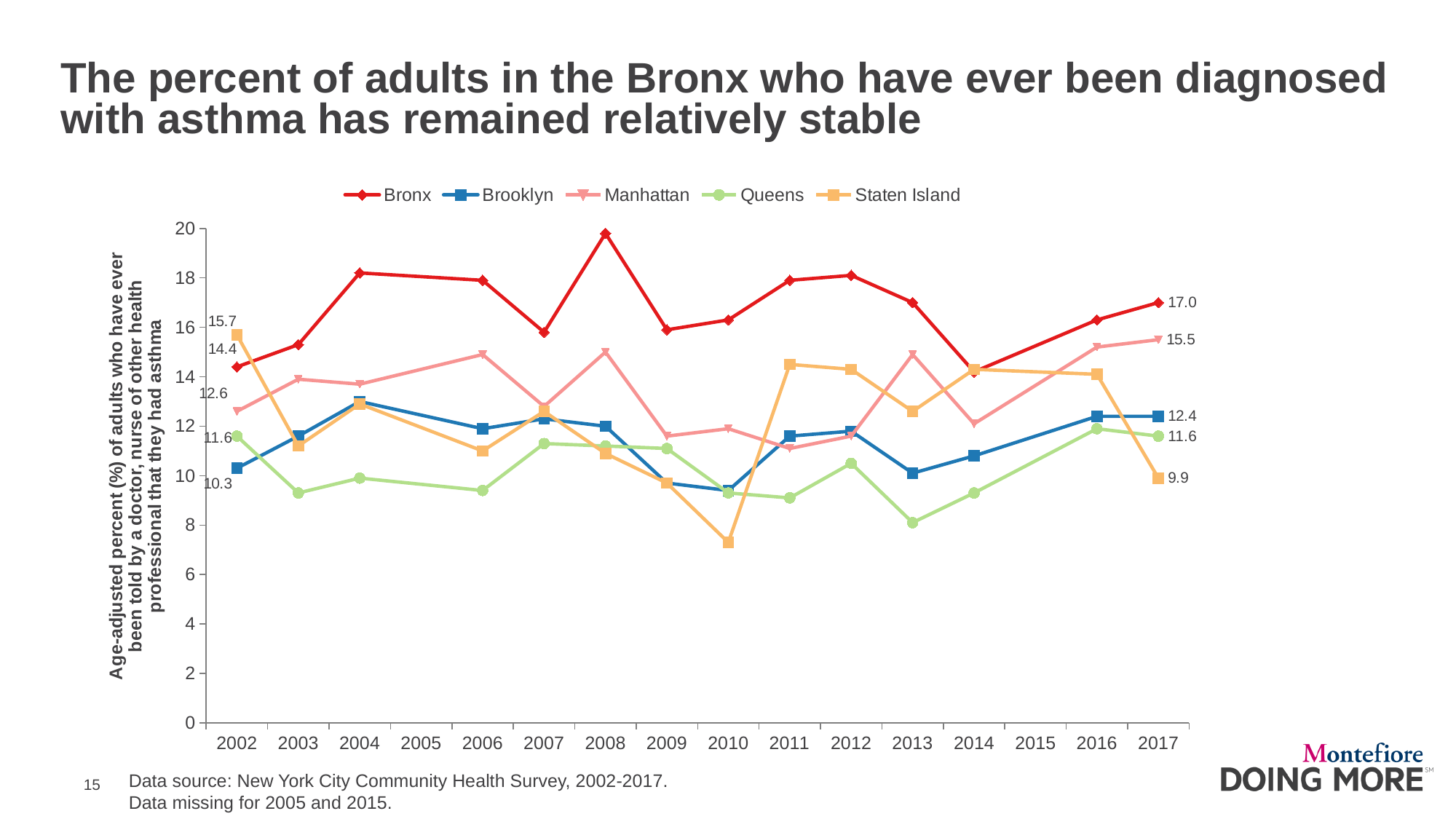
Is the value for the Bronx in 2008 greater or less than 18? greater What is the difference between the Staten Island value in 2002 and in 2017? 5.8 Which borough has the highest value in 2017? Bronx What is the value for Queens in 2017? 11.6 What is the value for the Bronx in 2017? 17.0 In 2017, which is larger: the value for Manhattan or the value for Brooklyn? Manhattan What is the difference between the Bronx value in 2017 and in 2002? 2.6 What is the value for Brooklyn in 2002? 10.3 Is the value for Staten Island in 2010 greater or less than 8? less Which borough has the lowest value in 2017? Staten Island What is the value for Staten Island in 2002? 15.7 How many series does the legend list? 5